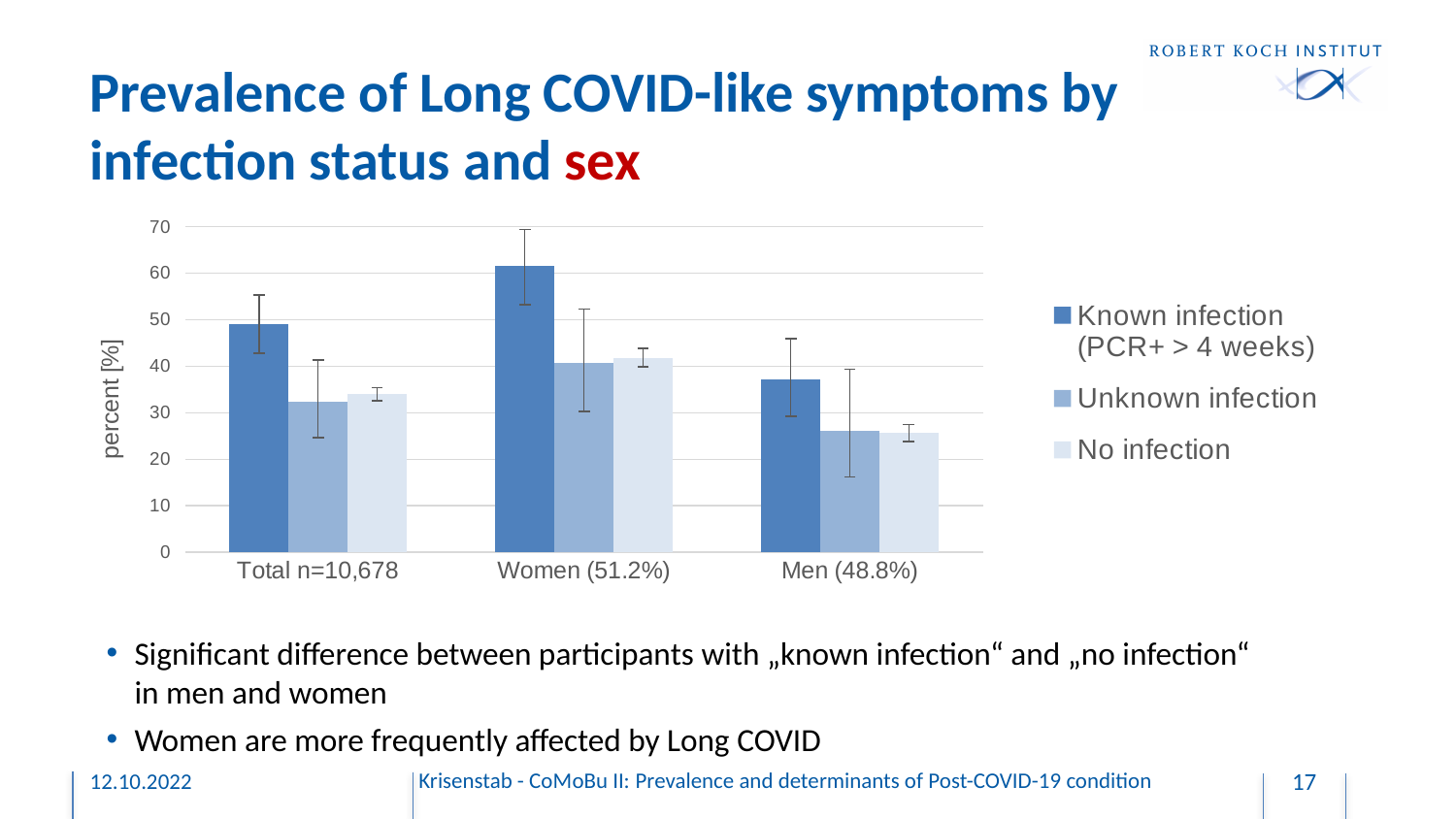
For Women (51.2%), which is larger: the Known infection value or the No infection value? Known infection How many categories are shown on the x axis? 3 Is the Known infection value for Men (48.8%) greater or less than 40? less Which category has the highest value for the Known infection (PCR+ > 4 weeks) series? Women (51.2%) How many series does the legend list? 3 What kind of chart is shown on the slide? bar chart What is the label of the y axis? percent [%] Is the Known infection value for Women (51.2%) greater or less than 50? greater Which category has the lowest value for the Known infection (PCR+ > 4 weeks) series? Men (48.8%) Is the Unknown infection value for Men (48.8%) greater or less than 30? less